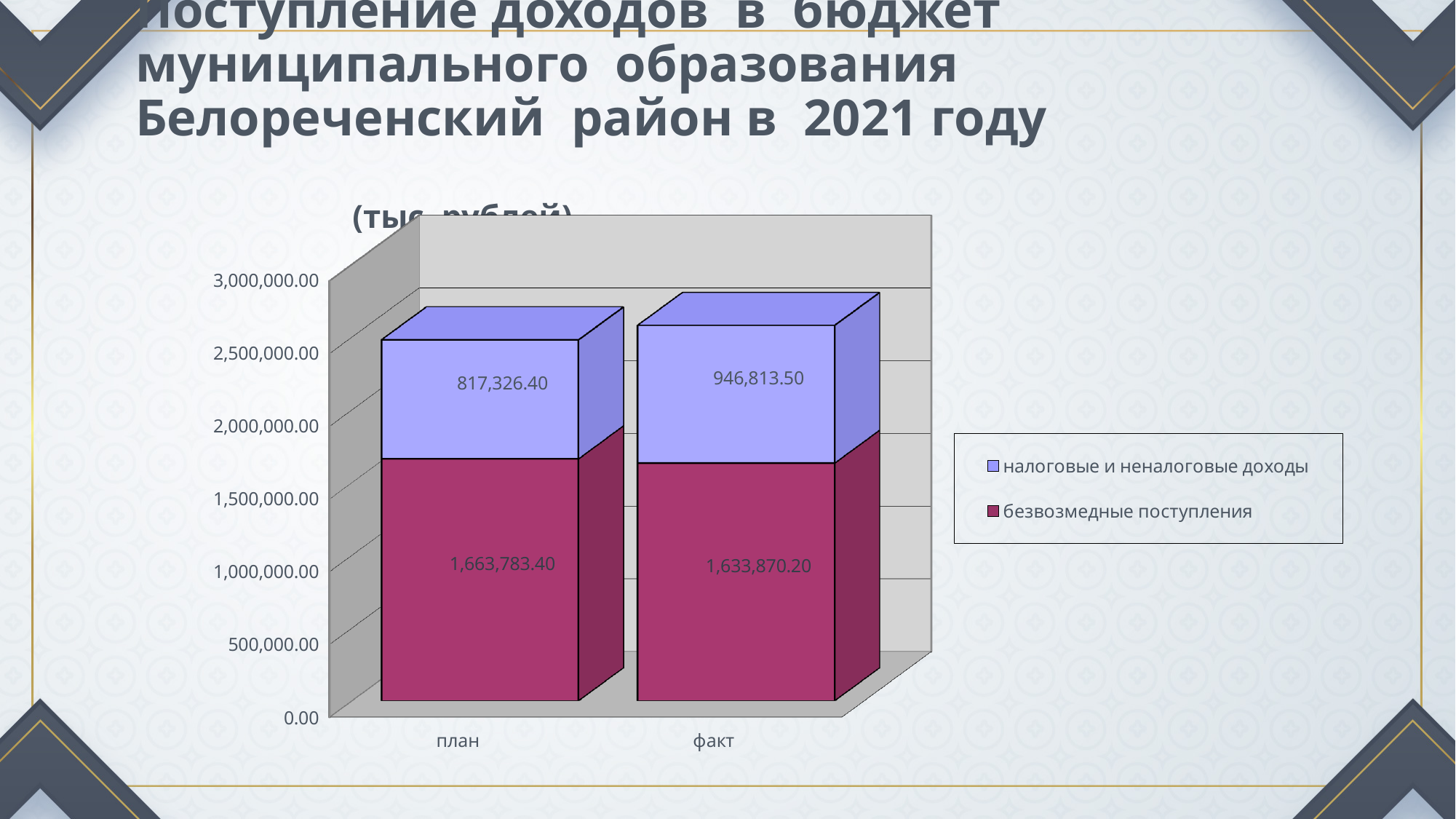
What is the total of the stacked bar for план? 2,481,109.80 What is the value of безвозмедные поступления for план? 1,663,783.40 What is the difference between the факт and план values for налоговые и неналоговые доходы? 129,487.10 How many series does the legend list? 2 What is the total of the stacked bar for факт? 2,580,683.70 Which category has the higher value for налоговые и неналоговые доходы, план or факт? факт What is the value of налоговые и неналоговые доходы for факт? 946,813.50 How many categories are shown on the x axis? 2 What is the value of безвозмедные поступления for факт? 1,633,870.20 What is the value of налоговые и неналоговые доходы for план? 817,326.40 What type of chart is shown on the slide? Stacked bar chart Which series is shown in red in the legend? безвозмедные поступления